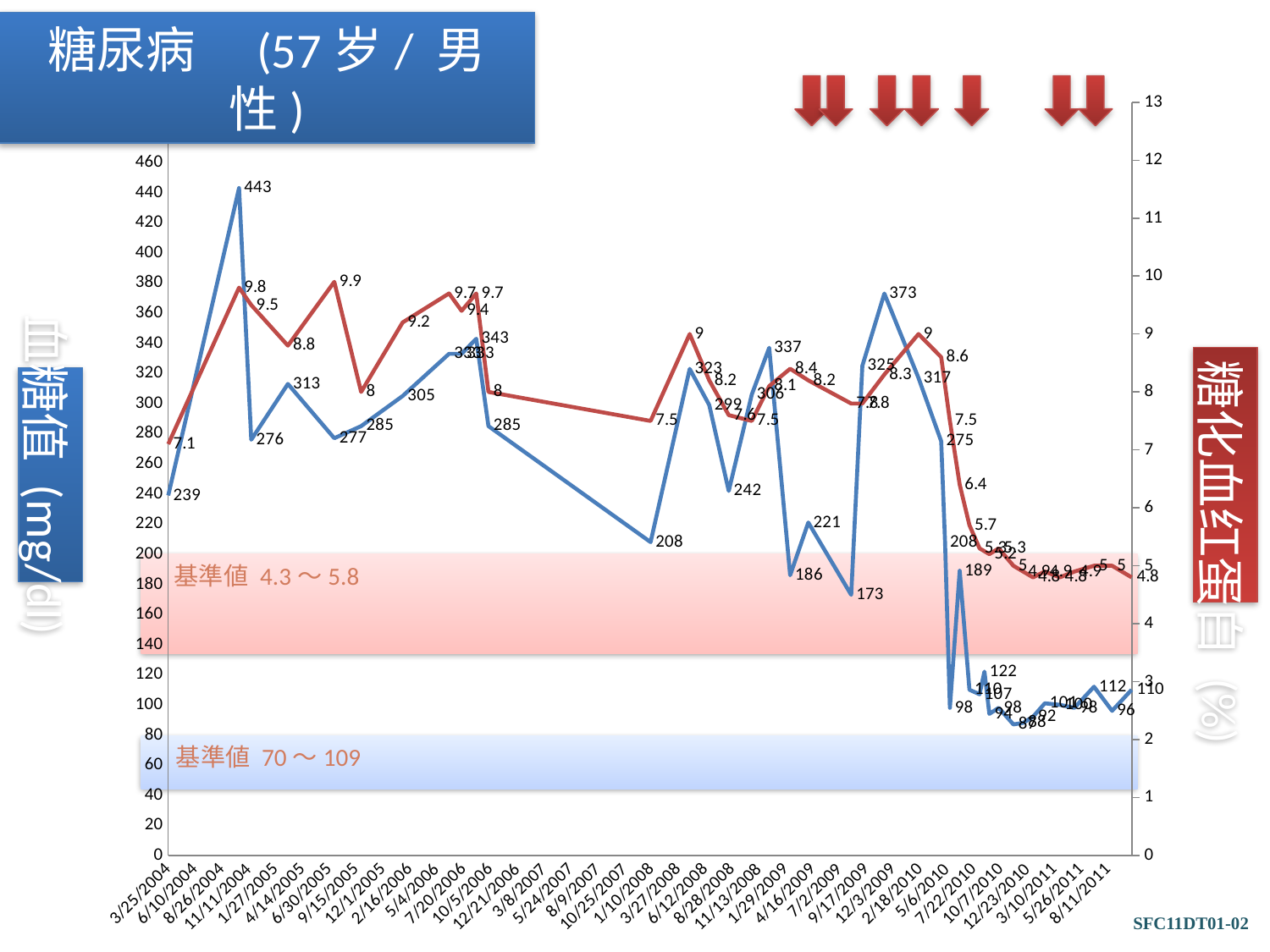
What reference range (基準値) is printed in the pink shaded band? 4.3～5.8 What is the maximum value shown on the left vertical axis? 460 Overall, does the blood glucose (blue line) rise or fall from the start to the end of the x axis? fall What is the difference between the peak blood glucose value of 443 and the first value of 239? 204 What is the highest blood glucose value (blue line) labelled on the chart? 443 What is the first blood glucose value labelled on the blue line, at 3/25/2004? 239 How many lines (series) are plotted on the chart? 2 Is the last blood glucose value on the blue line greater or less than 140? less What is the first HbA1c value labelled on the red line, at 3/25/2004? 7.1 Which is larger, the blood glucose peak labelled 443 or the later peak labelled 373? 443 What kind of chart is shown on the slide? line chart What is the highest HbA1c value (red line) labelled on the chart? 9.9